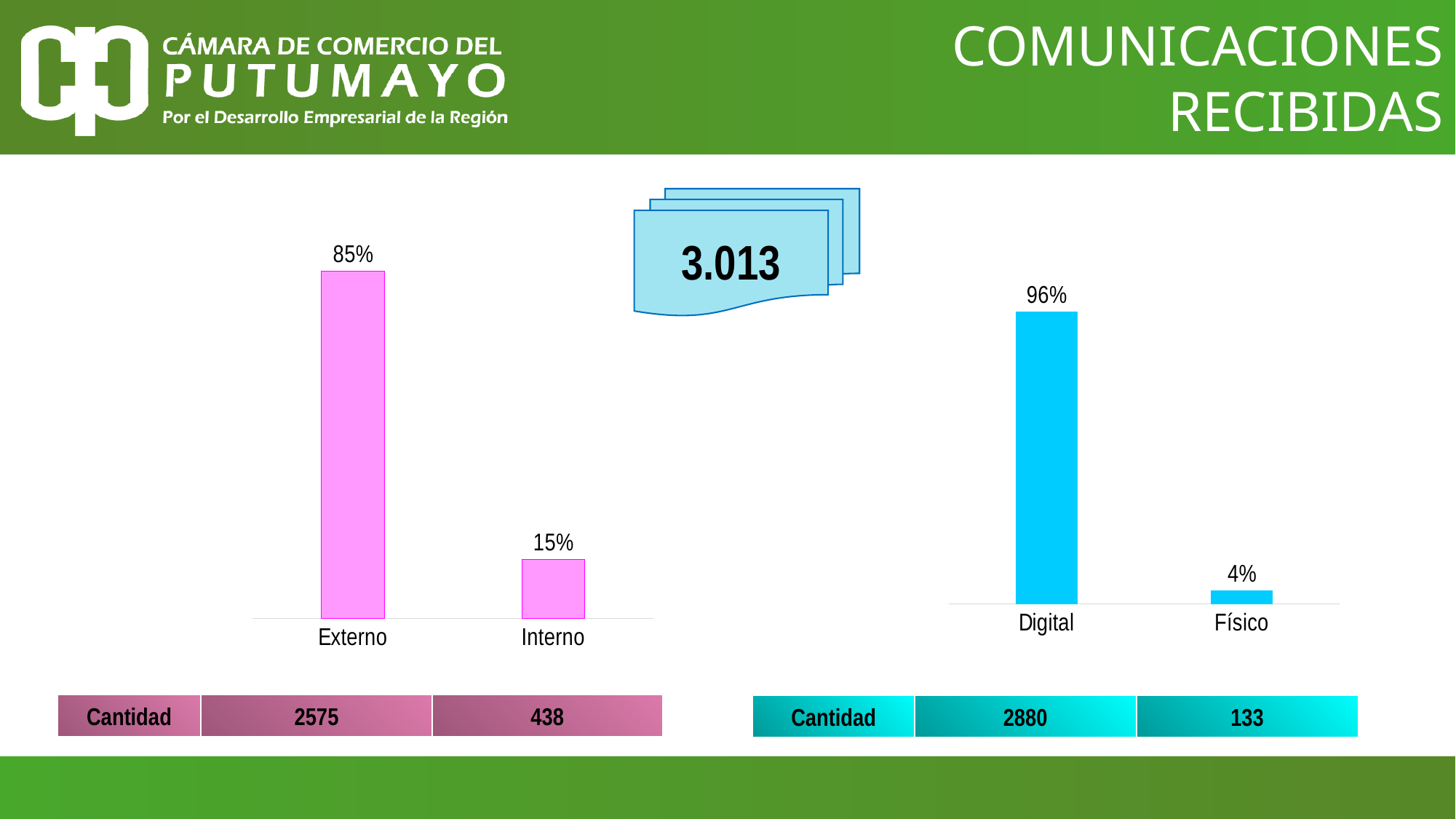
On the right chart, which is larger, the value for Digital or the value for Físico? Digital On the right chart, what is the value for Digital? 96% How many categories does the left chart show? 2 On the left chart, what is the value for Interno? 15% What kind of chart is the right chart? Bar chart On the right chart, what is the difference between the values for Digital and Físico? 92% On the right chart, which category has the lowest value? Físico On the right chart, what is the value for Físico? 4% On the left chart, what is the value for Externo? 85% What colour are the bars on the left chart? Pink On the left chart, which category has the highest value? Externo On the left chart, what is the difference between the values for Externo and Interno? 70%